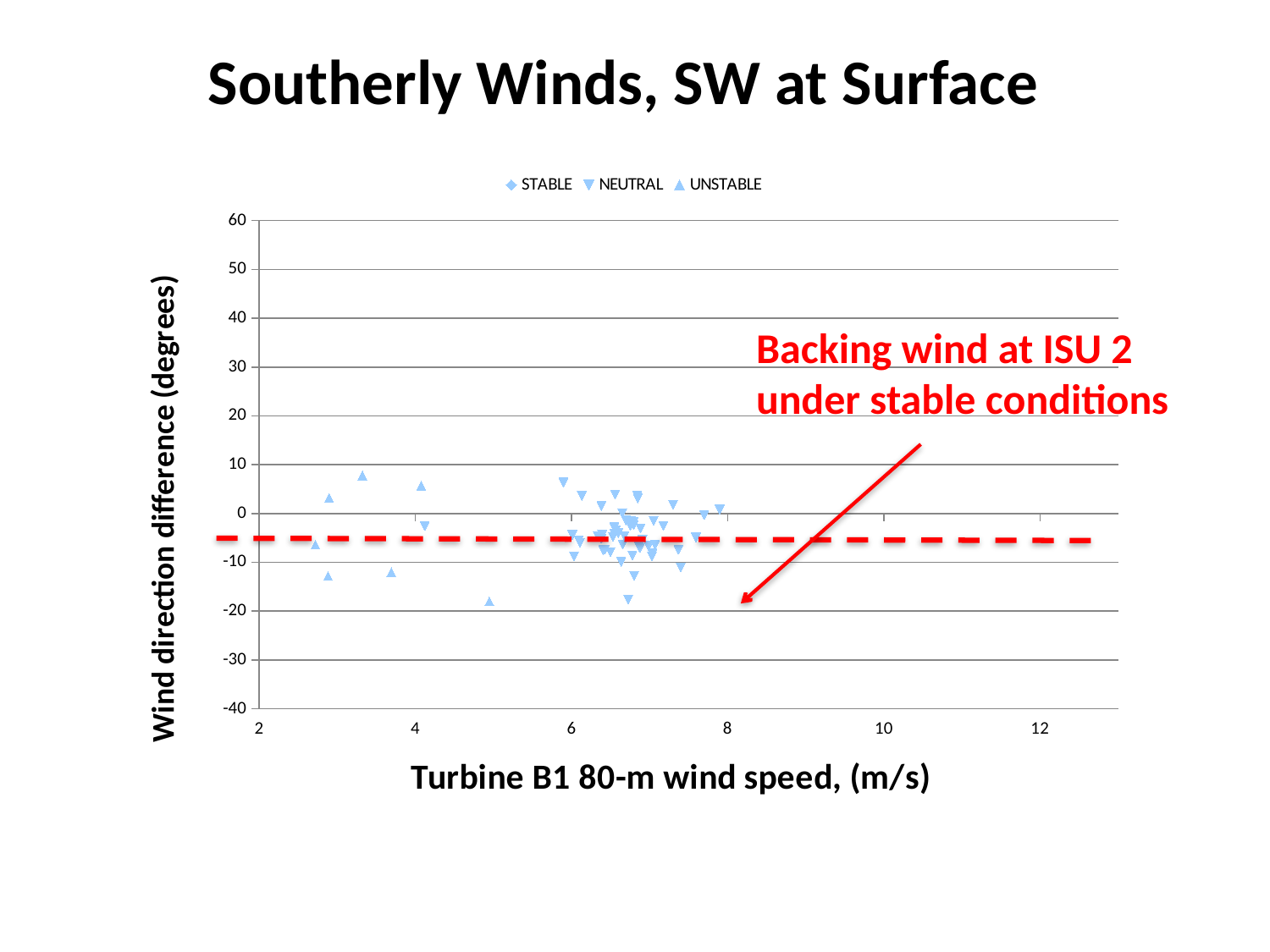
Is the highest plotted wind direction difference greater or less than 10? less What are the three series named in the legend? STABLE, NEUTRAL, UNSTABLE Is the lowest plotted wind direction difference greater or less than -10? less Is the highest plotted wind direction difference greater or less than 0? greater What kind of chart is shown on the slide? scatter chart How many series does the legend list? 3 What is the title of the chart's x axis? Turbine B1 80-m wind speed, (m/s)